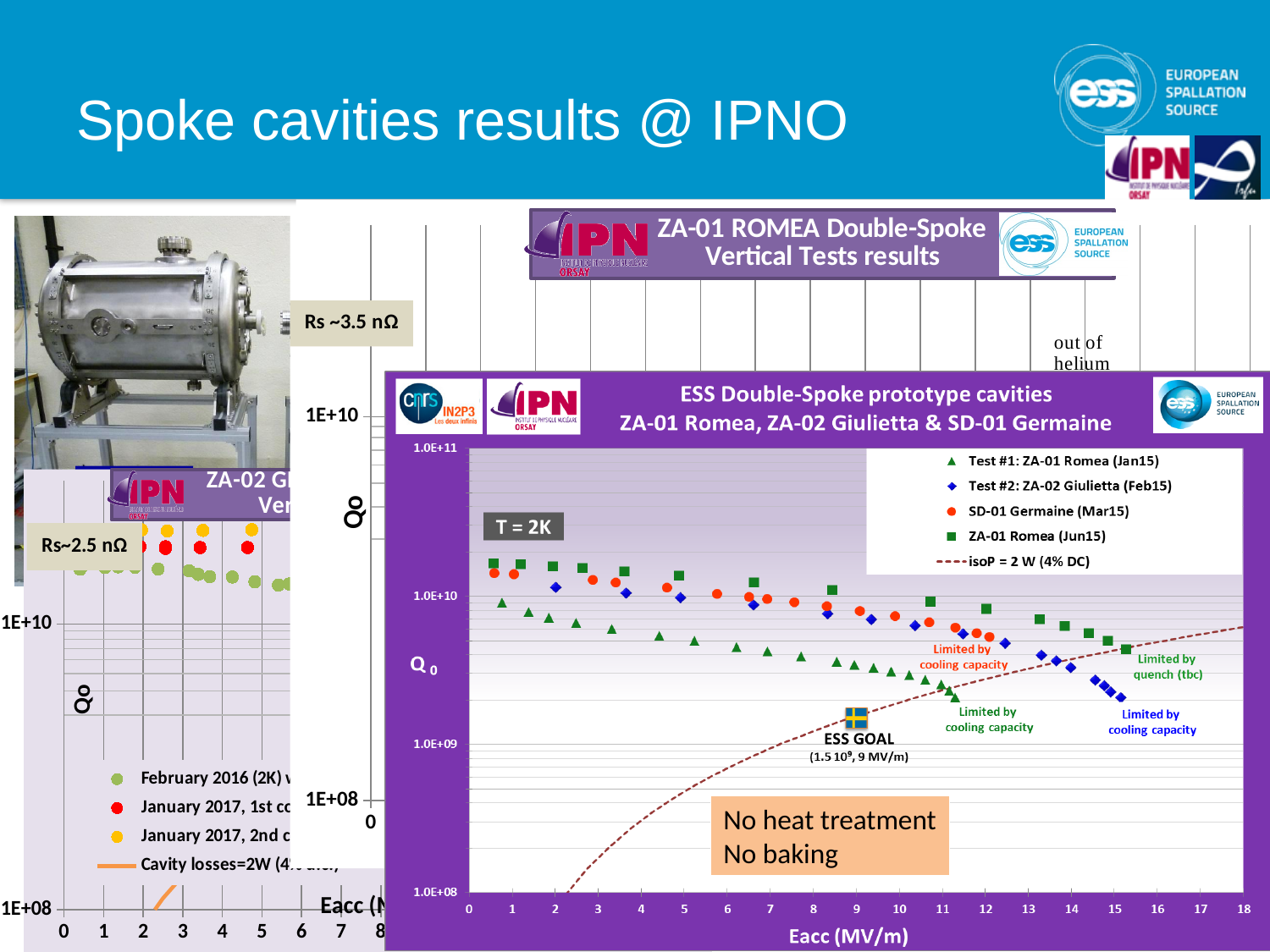
On the 'ESS Double-Spoke prototype cavities' chart, is the Q0 of SD-01 Germaine (Mar15) at Eacc = 1 MV/m greater or less than 1.0E+10? greater On the 'ESS Double-Spoke prototype cavities' chart, which series has the lowest Q0 values across the plotted Eacc range? Test #1: ZA-01 Romea (Jan15) On the 'ESS Double-Spoke prototype cavities' chart, what kind of chart is it? Scatter chart On the 'ESS Double-Spoke prototype cavities' chart, how many entries does the legend list? 5 On the 'ESS Double-Spoke prototype cavities' chart, which series reaches the highest Eacc value? ZA-01 Romea (Jun15) On the 'ESS Double-Spoke prototype cavities' chart, is the Q0 of Test #1: ZA-01 Romea (Jan15) at Eacc = 11 MV/m greater or less than 1.0E+10? less On the 'ESS Double-Spoke prototype cavities' chart, what is the label of the x axis? Eacc (MV/m) On the 'ESS Double-Spoke prototype cavities' chart, what temperature is stated in the box on the plot? T = 2K On the 'ESS Double-Spoke prototype cavities' chart, what limitation is noted for Test #2: ZA-02 Giulietta (Feb15) at its highest Eacc points? Limited by cooling capacity On the 'ESS Double-Spoke prototype cavities' chart, what is the highest tick value shown on the Eacc axis? 18 On the 'ESS Double-Spoke prototype cavities' chart, does Q0 for the series generally rise or fall as Eacc increases? Fall On the 'ESS Double-Spoke prototype cavities' chart, what Q0 and Eacc values are given for the ESS GOAL marker? 1.5 10⁹, 9 MV/m